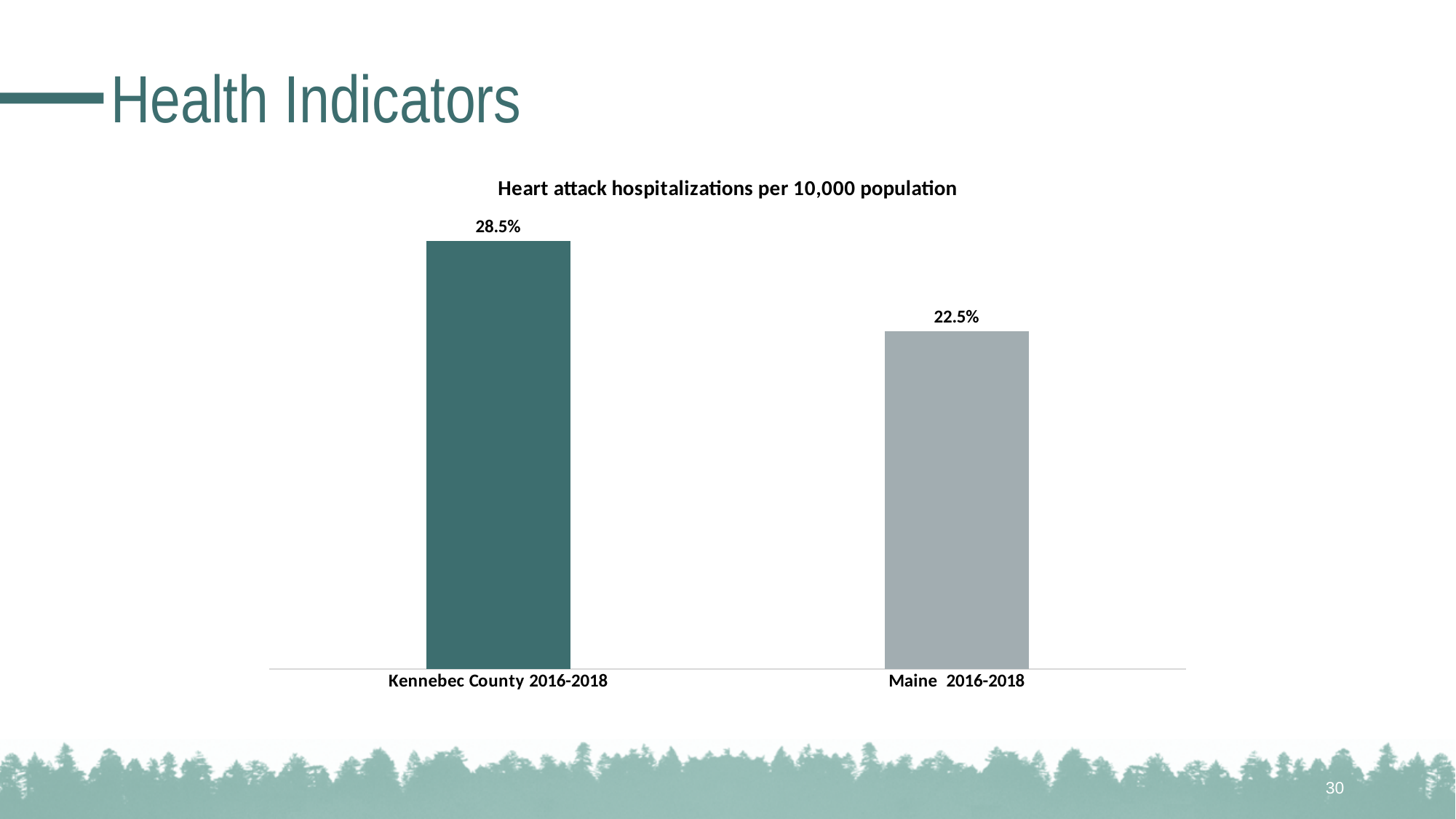
What is the value for Kennebec County 2016-2018? 28.5% How many categories are shown in the chart? 2 Which category has the lowest value? Maine 2016-2018 Which is larger, the value for Kennebec County 2016-2018 or the value for Maine 2016-2018? Kennebec County 2016-2018 What kind of chart is shown on the slide? Bar chart Which category has the highest value? Kennebec County 2016-2018 What colour is the bar for Kennebec County 2016-2018? Dark teal What is the title of the chart? Heart attack hospitalizations per 10,000 population What is the difference between the values for Kennebec County 2016-2018 and Maine 2016-2018? 6.0% What is the value for Maine 2016-2018? 22.5%